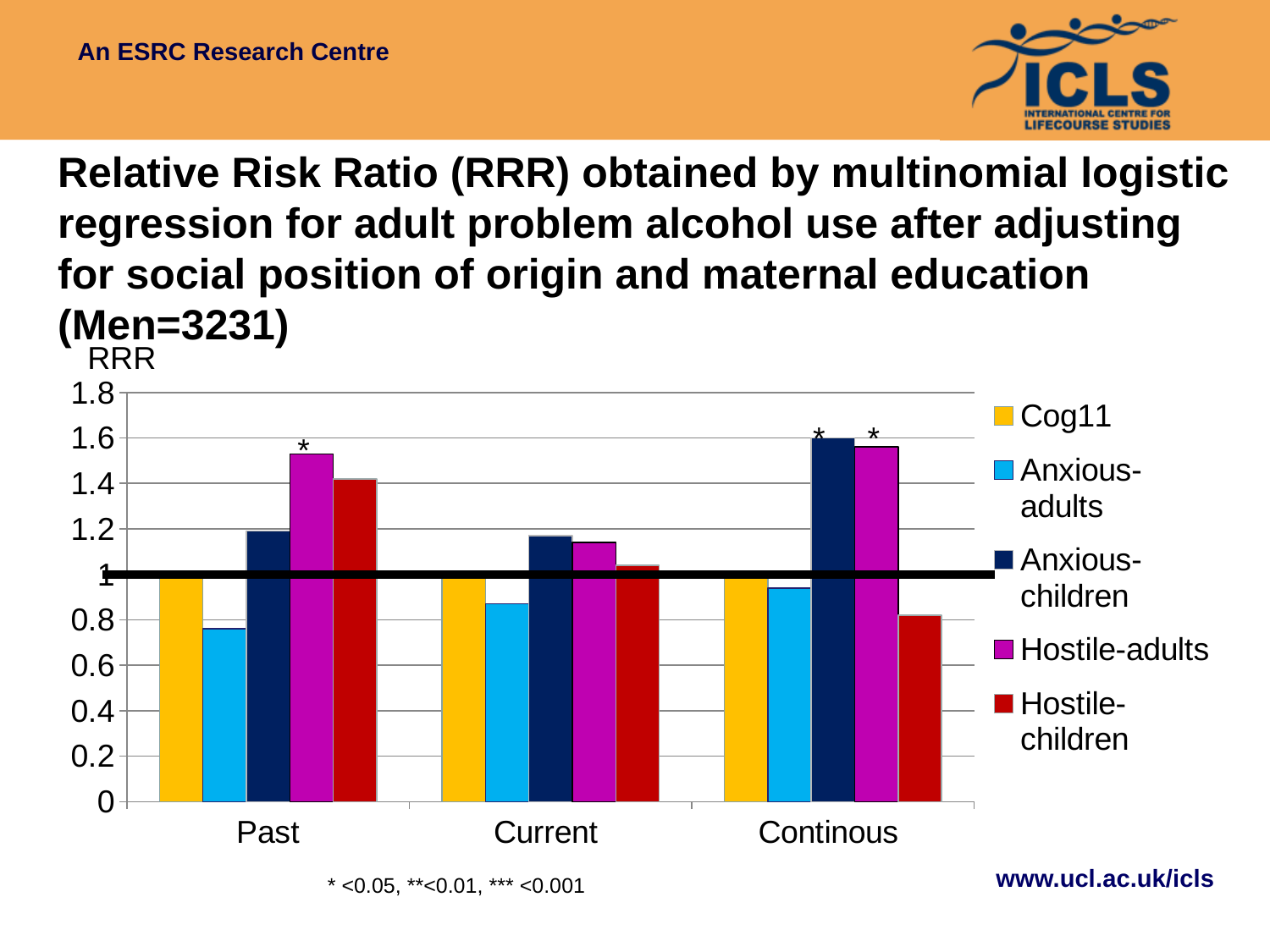
Is the value for Anxious-adults in the Past category greater or less than 0.8? less What kind of chart is shown on the slide? bar chart How many categories are shown on the x axis of the chart? 3 Which series has the lowest value in the Continous category? Hostile-children Which series has the highest value in the Past category? Hostile-adults What label is shown on the vertical axis of the chart? RRR Which is larger: the Hostile-adults value for Past or the Hostile-adults value for Current? Past Is the value for Hostile-children in the Continous category greater or less than 1? less Is the value for Hostile-adults in the Past category greater or less than 1.4? greater What is the value for Cog11 in the Past category? 1 How many series does the chart's legend list? 5